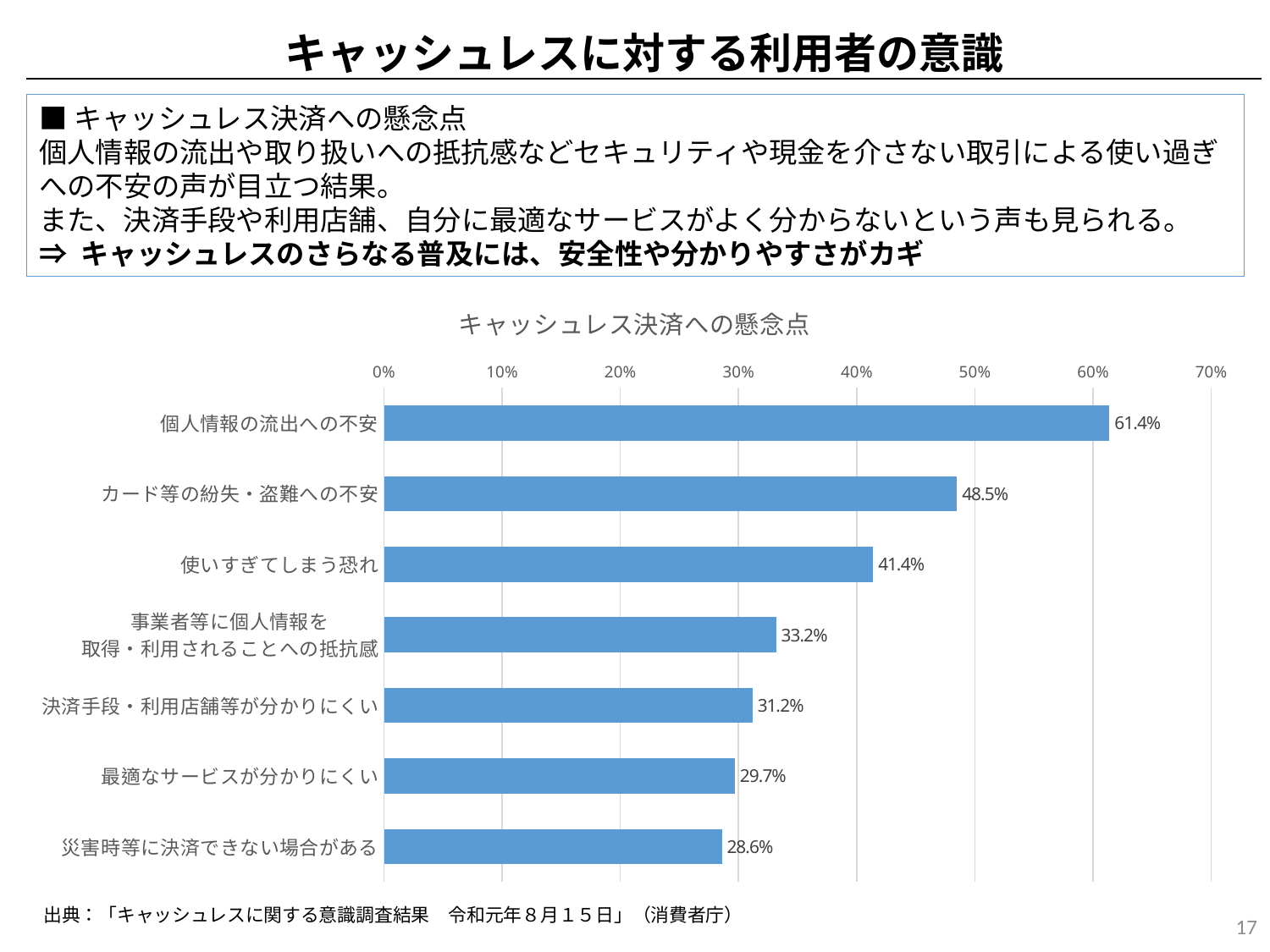
Which category has the highest value? 個人情報の流出への不安 Which category has the lowest value? 災害時等に決済できない場合がある Which is larger, 決済手段・利用店舗等が分かりにくい or 最適なサービスが分かりにくい? 決済手段・利用店舗等が分かりにくい What is the difference between 個人情報の流出への不安 and カード等の紛失・盗難への不安? 12.9% Is the value for カード等の紛失・盗難への不安 greater or less than 40%? greater What is the value for 個人情報の流出への不安? 61.4% What is the value for 使いすぎてしまう恐れ? 41.4% What kind of chart is shown on the slide? bar chart What is the value for 災害時等に決済できない場合がある? 28.6% How many categories are shown in the chart? 7 What is the title of the chart? キャッシュレス決済への懸念点 What is the value for 事業者等に個人情報を取得・利用されることへの抵抗感? 33.2%